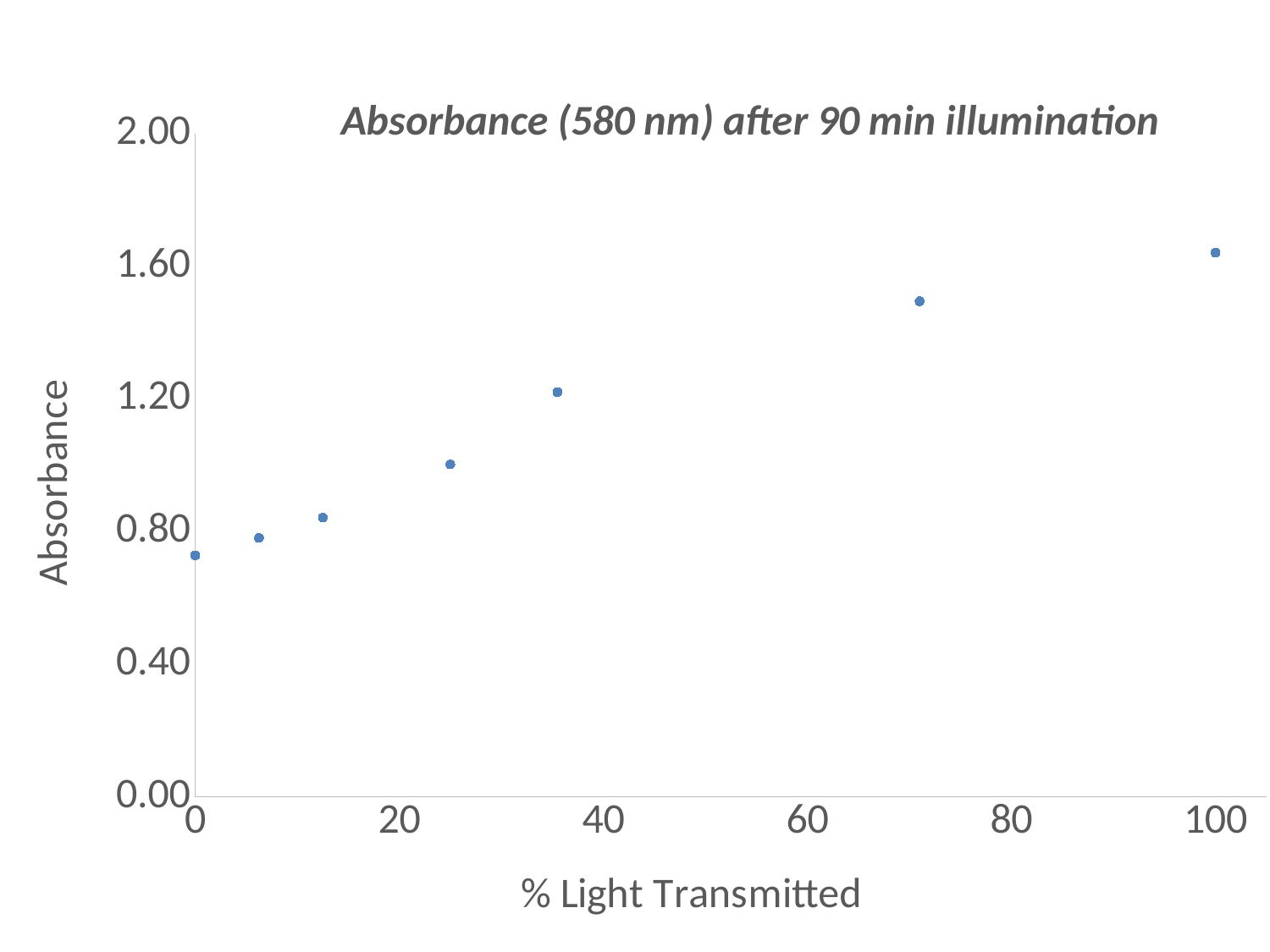
What kind of chart is shown on the slide? scatter chart Is the absorbance for the point near 25% light transmitted greater or less than 0.80? greater Do the absorbance values rise or fall as % light transmitted increases? rise Which has the larger absorbance: the point at 100% light transmitted or the point near 70% light transmitted? 100% light transmitted How many data points are plotted on the chart? 7 Is the absorbance at 100% light transmitted greater or less than 1.20? greater Is the absorbance for the point near 70% light transmitted greater or less than 1.60? less What is the title of the chart? Absorbance (580 nm) after 90 min illumination At which % light transmitted value is the absorbance highest? 100 What is the label of the x axis? % Light Transmitted At which % light transmitted value is the absorbance lowest? 0